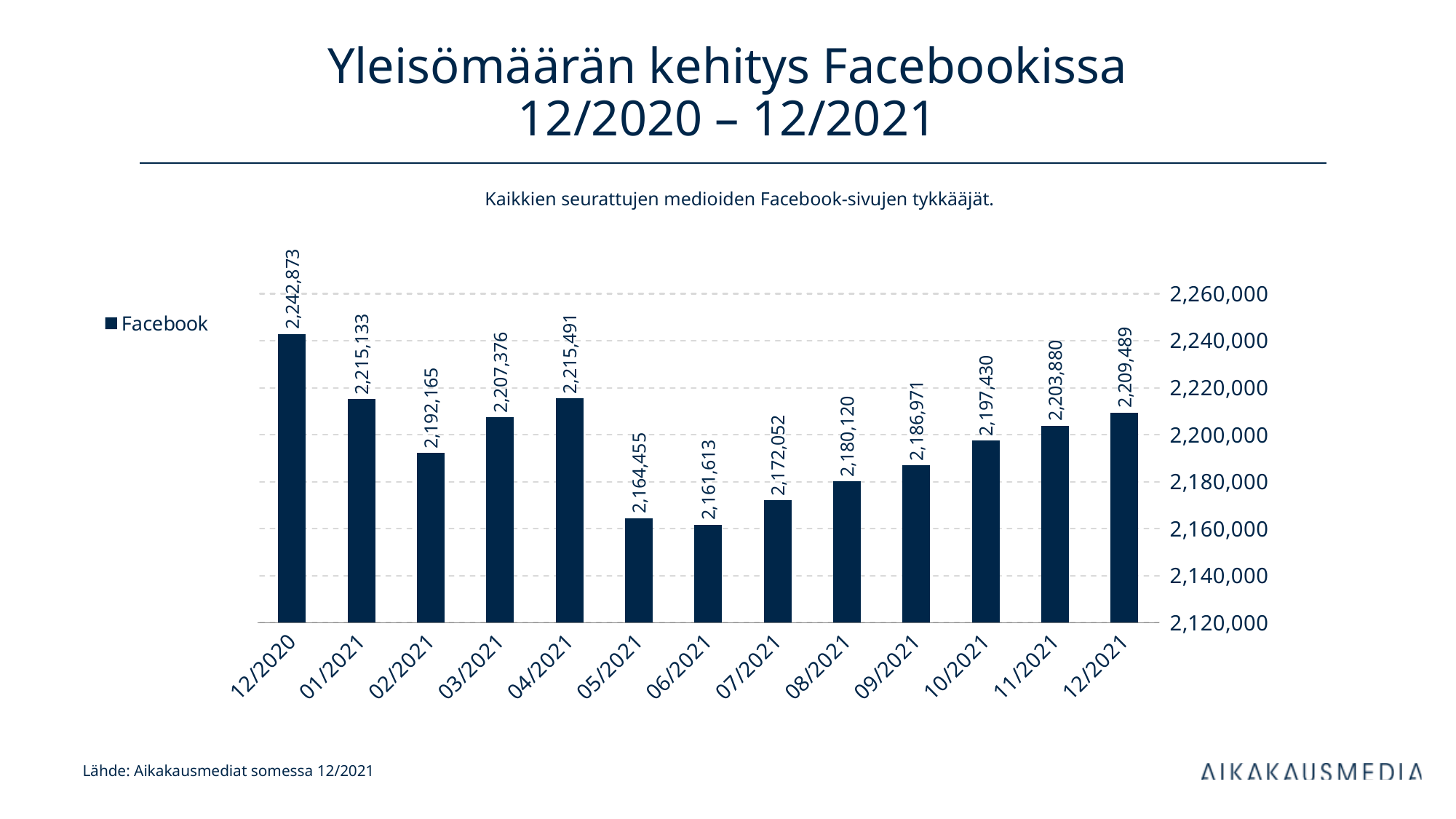
What is the value for 12/2020? 2,242,873 What is the value for 06/2021? 2,161,613 What is the difference between the values for 12/2020 and 12/2021? 33,384 Is the value for 08/2021 greater or less than 2,200,000? less What is the value for 12/2021? 2,209,489 What is the only series listed in the legend? Facebook How many months are shown on the x axis? 13 Which month has the highest value? 12/2020 Which month has the lowest value? 06/2021 What kind of chart is shown on the slide? bar chart Which is larger, the value for 01/2021 or the value for 02/2021? 01/2021 What is the difference between the values for 04/2021 and 03/2021? 8,115